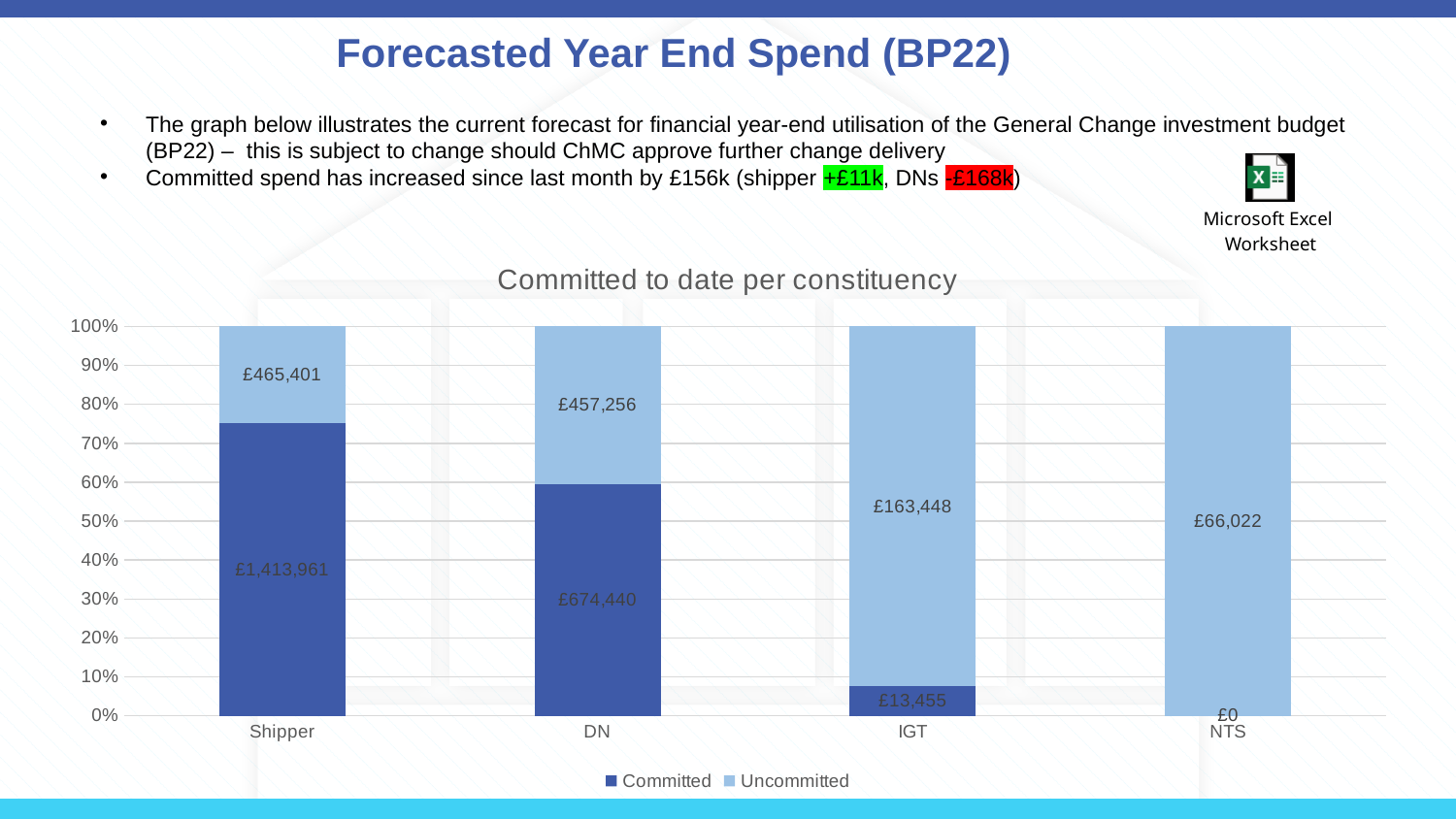
What is the total of Committed and Uncommitted for DN? £1,131,696 How many constituencies are shown on the x axis of the chart? 4 What is the title of the chart? Committed to date per constituency Which constituency has the lowest Uncommitted value? NTS What is the Committed value for Shipper? £1,413,961 Which is larger for IGT, the Committed value or the Uncommitted value? Uncommitted How many series does the chart legend list? 2 Which constituency has the highest Committed value? Shipper What is the Uncommitted value for DN? £457,256 What is the difference between the Committed values for Shipper and DN? £739,521 What type of chart is shown on the slide? stacked bar chart What is the Committed value for NTS? £0